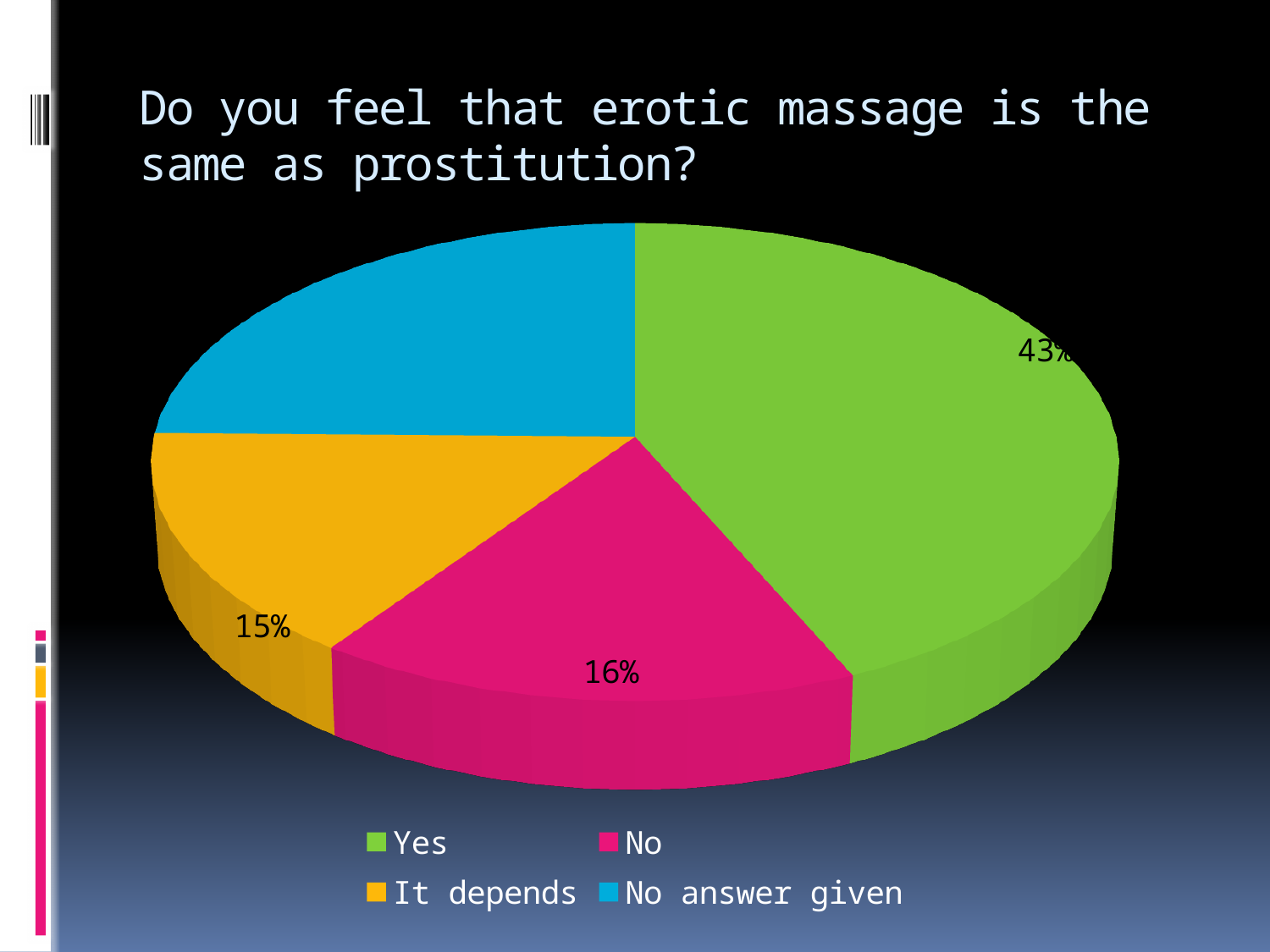
What is the difference in percentage points between "Yes" and "No"? 27% Which is larger, the share for "Yes" or the share for "No answer given"? Yes What colour represents "No answer given" in the chart? blue How many categories does the legend list? 4 What type of chart is shown on the slide? pie chart What is the title of the chart? Do you feel that erotic massage is the same as prostitution? Which response has the largest share of the pie? Yes What percentage of respondents answered "No"? 16% What is the difference in percentage points between "No" and "It depends"? 1% What percentage of respondents answered "Yes"? 43% Which response has the smallest share of the pie? It depends What percentage of respondents answered "It depends"? 15%